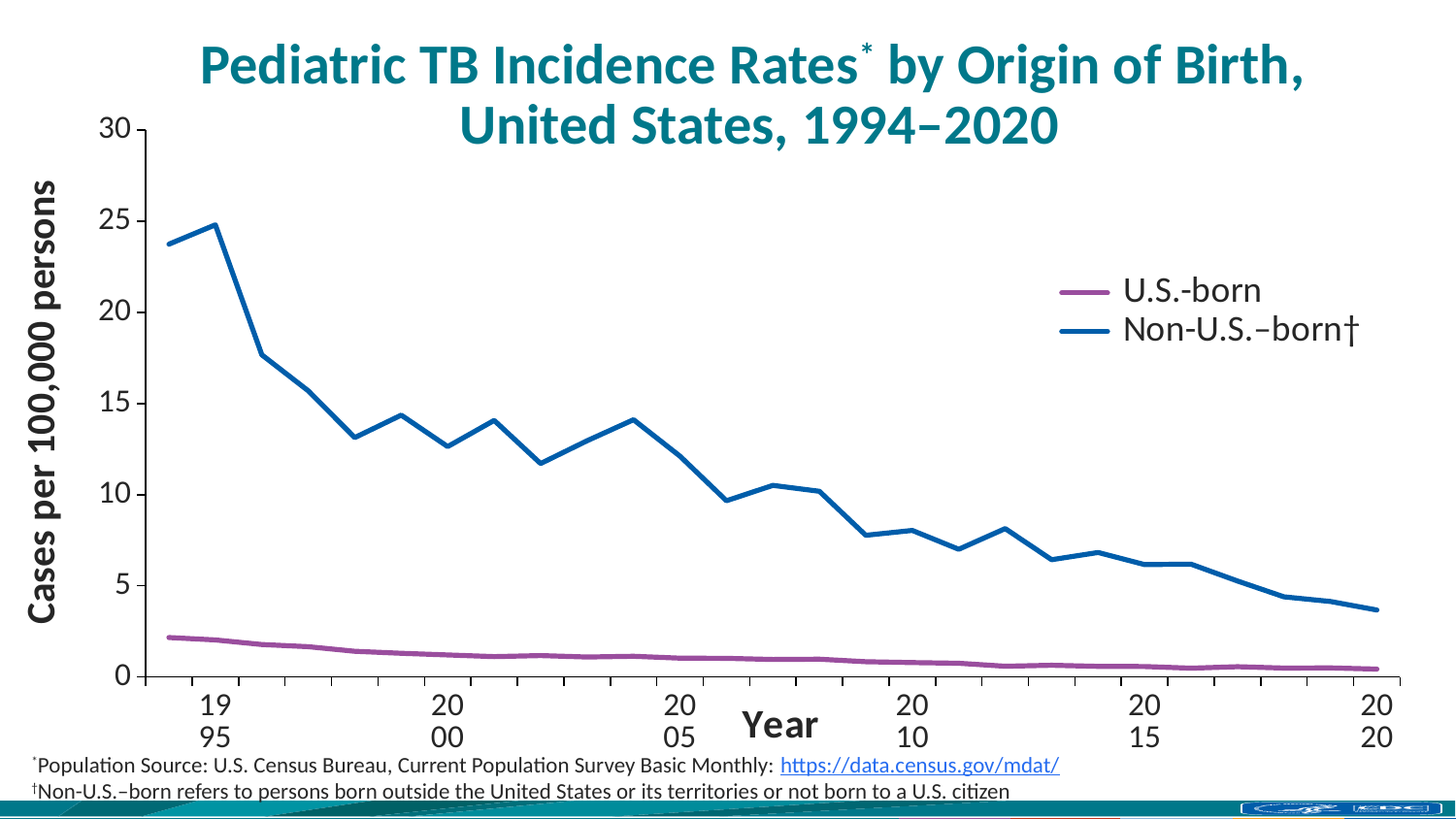
Is the U.S.-born value for 1995 greater or less than 5? less Is the Non-U.S.-born value for 2005 greater or less than 10? greater Which two series are listed in the legend? U.S.-born and Non-U.S.–born Is the Non-U.S.-born value for 1995 greater or less than 20? greater How many series does the legend list? 2 Does the Non-U.S.-born incidence rate rise or fall overall from 1994 to 2020? fall Does the U.S.-born incidence rate rise or fall overall from 1994 to 2020? fall What kind of chart is shown on the slide? line chart What is the label on the y axis? Cases per 100,000 persons In 2000, which series has the higher incidence rate, U.S.-born or Non-U.S.-born? Non-U.S.-born